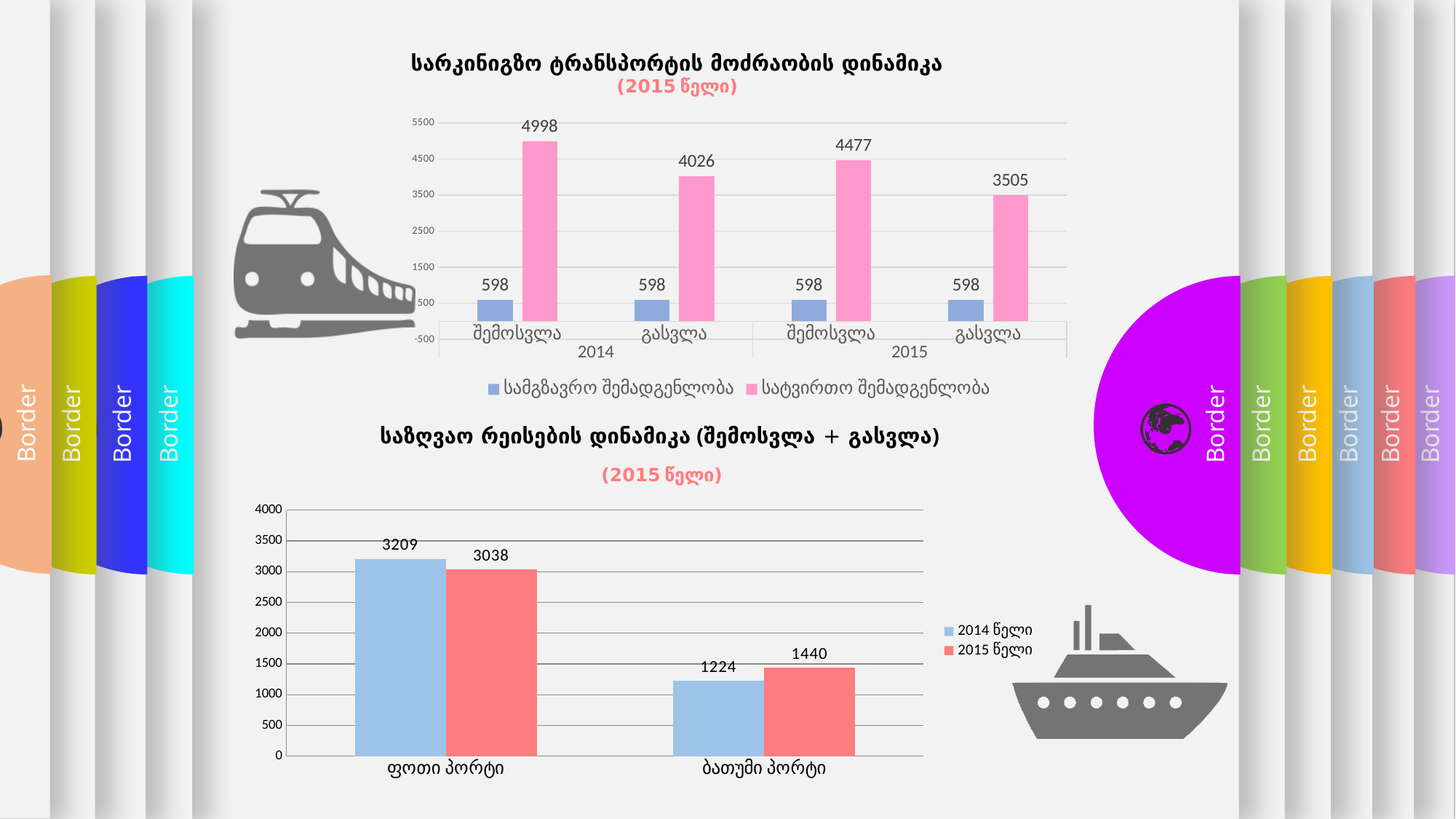
In the bottom chart (საზღვაო რეისების დინამიკა), what is the value for ფოთი პორტი in 2015 წელი? 3038 In the top chart (სარკინიგზო ტრანსპორტის მოძრაობის დინამიკა), which category has the highest სატვირთო შემადგენლობა value? შემოსვლა 2014 In the bottom chart (საზღვაო რეისების დინამიკა), which is larger for ბათუმი პორტი: 2014 წელი or 2015 წელი? 2015 წელი How many series does the legend of the top chart (სარკინიგზო ტრანსპორტის მოძრაობის დინამიკა) list? 2 In the top chart (სარკინიგზო ტრანსპორტის მოძრაობის დინამიკა), what is the value of სატვირთო შემადგენლობა for შემოსვლა in 2014? 4998 In the bottom chart (საზღვაო რეისების დინამიკა), what is the value for ბათუმი პორტი in 2014 წელი? 1224 In the top chart (სარკინიგზო ტრანსპორტის მოძრაობის დინამიკა), what is the value of სატვირთო შემადგენლობა for გასვლა in 2015? 3505 In the bottom chart (საზღვაო რეისების დინამიკა), what is the difference between the 2014 წელი and 2015 წელი values for ფოთი პორტი? 171 What kind of chart is the bottom chart (საზღვაო რეისების დინამიკა)? Bar chart How many categories are shown on the x axis of the bottom chart (საზღვაო რეისების დინამიკა)? 2 In the top chart (სარკინიგზო ტრანსპორტის მოძრაობის დინამიკა), what is the difference between the სატვირთო შემადგენლობა values for შემოსვლა and გასვლა in 2015? 972 In the top chart (სარკინიგზო ტრანსპორტის მოძრაობის დინამიკა), what is the value of სამგზავრო შემადგენლობა for გასვლა in 2014? 598